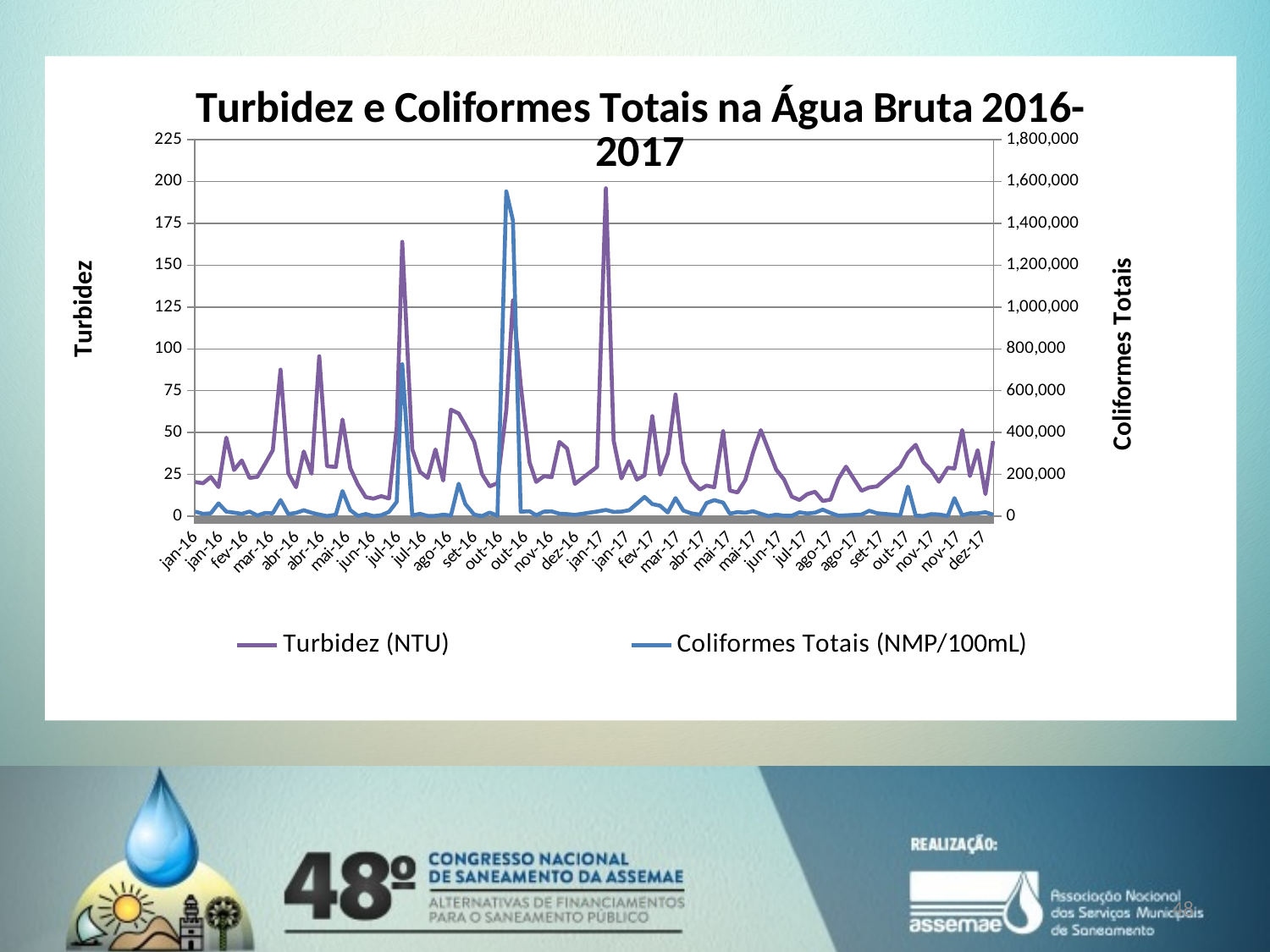
Is the highest peak of Coliformes Totais (NMP/100mL), around out-16, greater or less than 1,400,000? greater Which Turbidez (NTU) peak is higher: the one around jul-16 or the one around jan-17? jan-17 Which series is plotted in blue according to the legend? Coliformes Totais (NMP/100mL) Is the Coliformes Totais (NMP/100mL) value around dez-17 greater or less than 200,000? less Around which month does the Turbidez (NTU) series reach its highest peak? jan-17 How many series does the legend list? 2 Is the Turbidez (NTU) value at the first point, jan-16, greater or less than 50? less Around which month does the Coliformes Totais (NMP/100mL) series reach its highest peak? out-16 What kind of chart is shown on the slide? line chart What is the title of the chart? Turbidez e Coliformes Totais na Água Bruta 2016-2017